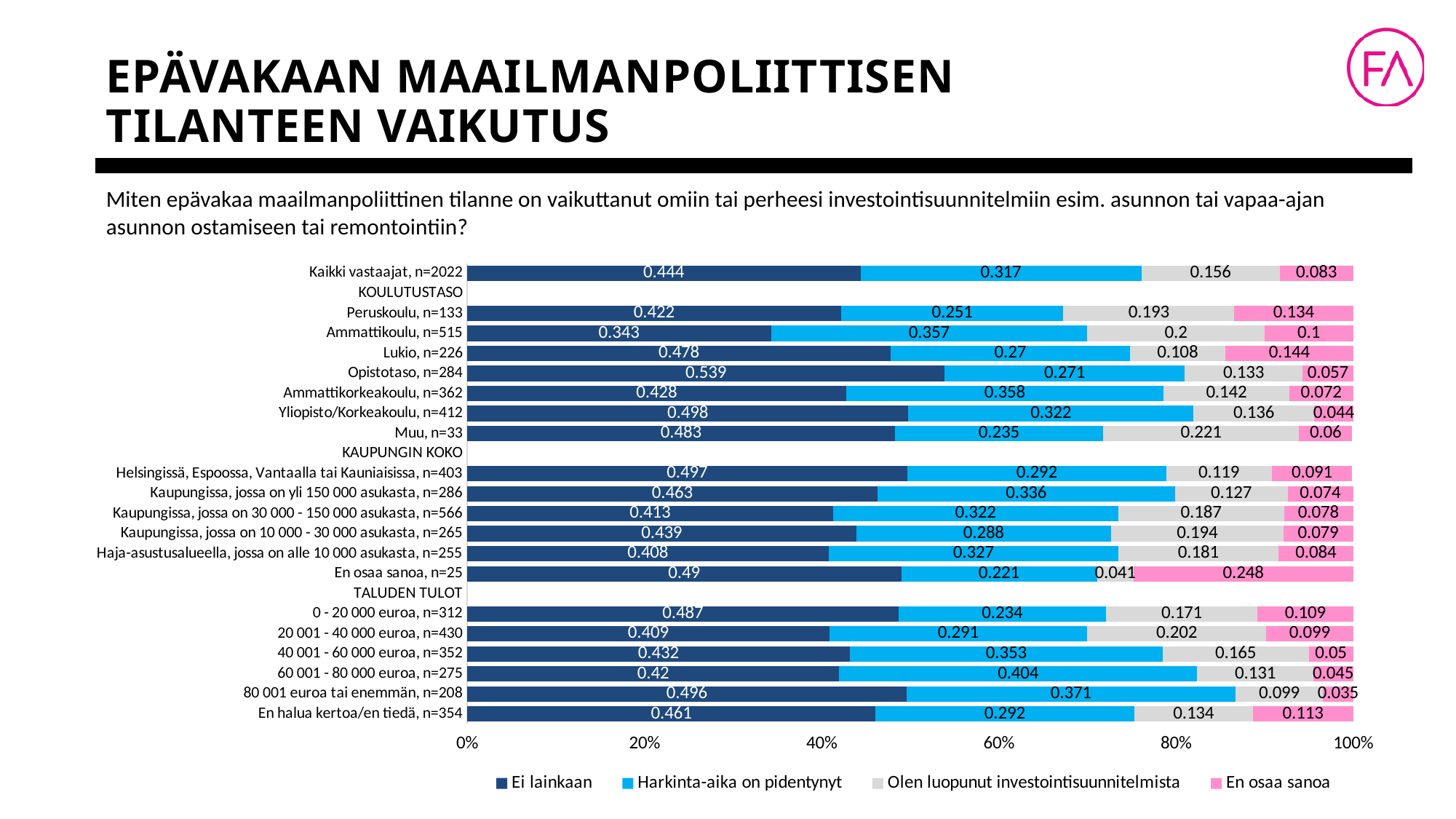
Which legend entry is shown in pink? En osaa sanoa What is the difference between the "Ei lainkaan" values for Lukio, n=226 and Peruskoulu, n=133? 0.056 Which category has the lowest value for "En osaa sanoa"? 80 001 euroa tai enemmän, n=208 What is the value of "Olen luopunut investointisuunnitelmista" for Muu, n=33? 0.221 What is the value of "Harkinta-aika on pidentynyt" for 80 001 euroa tai enemmän, n=208? 0.371 Is the "Ei lainkaan" value for Opistotaso, n=284 greater or less than 50%? greater What is the value of "En osaa sanoa" for Lukio, n=226? 0.144 How many series does the legend list? 4 What kind of chart is shown on the slide? Stacked bar chart What is the value of "Ei lainkaan" for Kaikki vastaajat, n=2022? 0.444 Which has the larger "Harkinta-aika on pidentynyt" value: 60 001 - 80 000 euroa, n=275 or 0 - 20 000 euroa, n=312? 60 001 - 80 000 euroa, n=275 Which category has the highest value for "Ei lainkaan"? Opistotaso, n=284